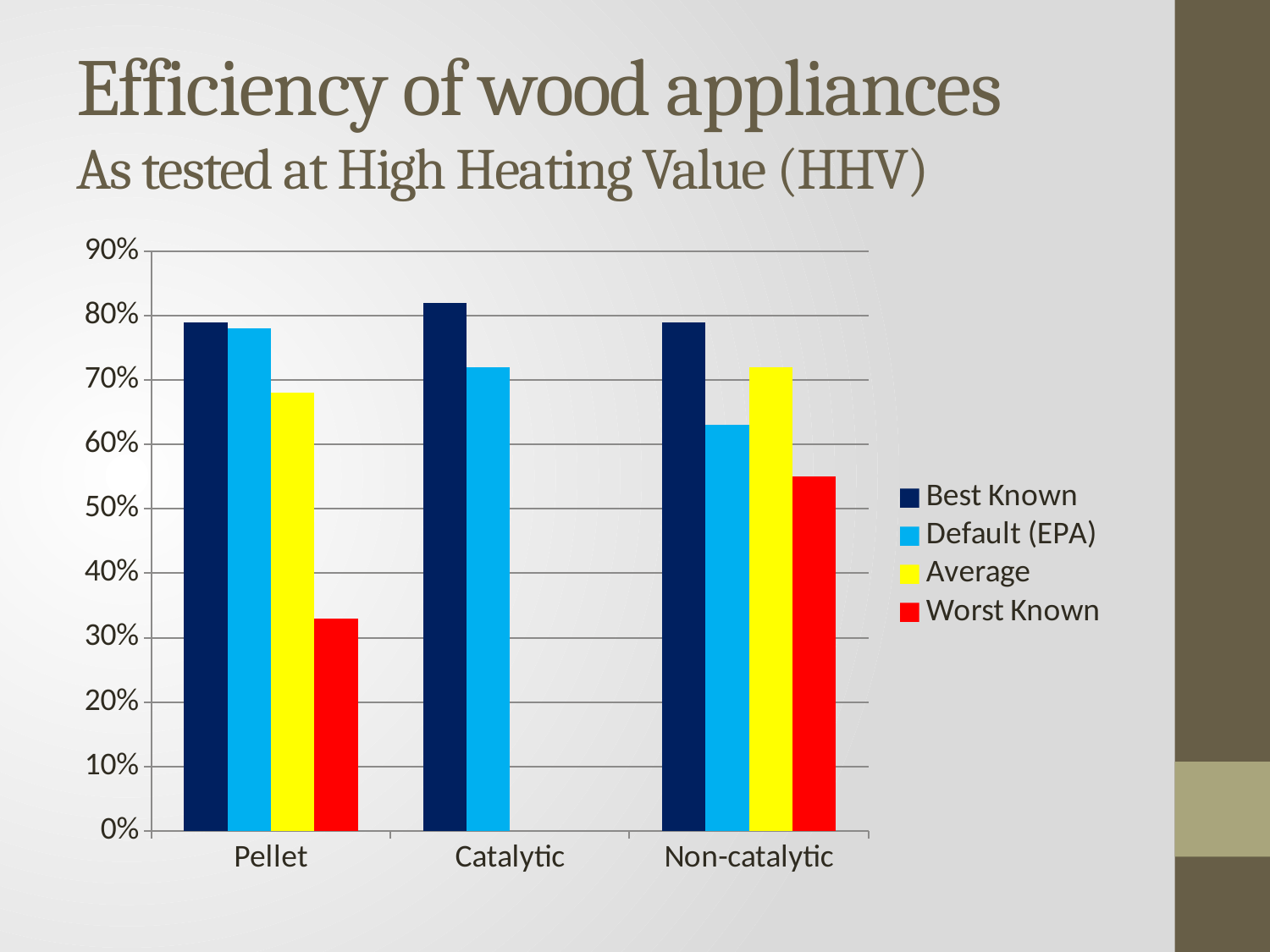
Which category has no Average or Worst Known bars shown? Catalytic What colour represents the Worst Known series in the legend? red Is the Best Known value for Catalytic greater or less than 80%? greater Which category has the highest Best Known efficiency? Catalytic Is the Default (EPA) value for Non-catalytic greater or less than 70%? less How many series does the legend list? 4 Is the Worst Known value for Pellet greater or less than 40%? less What kind of chart is shown on the slide? bar chart Which is larger, the Average value for Pellet or the Average value for Non-catalytic? Non-catalytic How many appliance categories are shown on the x axis? 3 Which category has the lowest Worst Known efficiency? Pellet